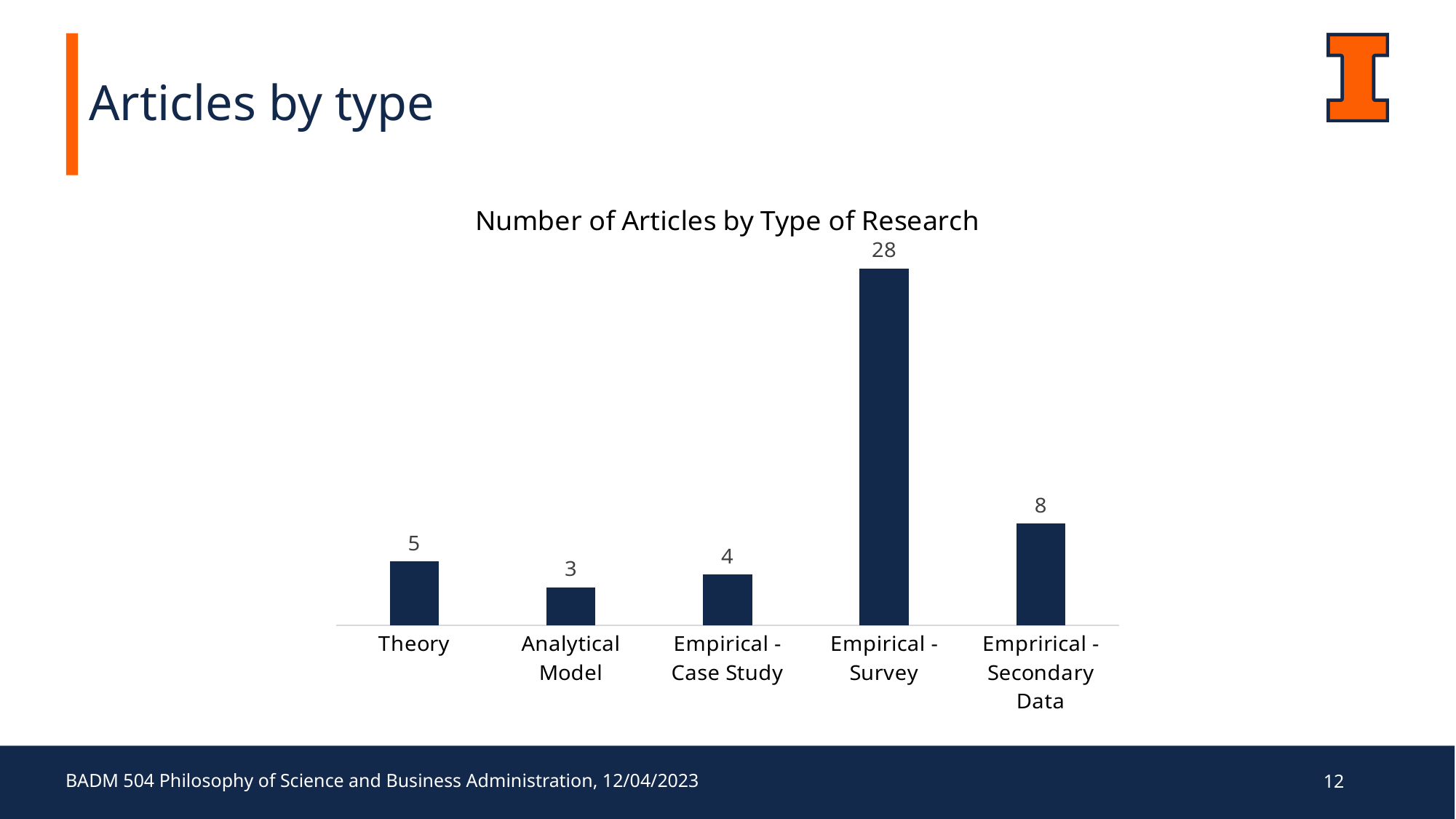
What is the number of articles for Emprirical - Secondary Data? 8 What is the number of articles for Empirical - Case Study? 4 Which has more articles, Theory or Empirical - Case Study? Theory What is the number of articles for Analytical Model? 3 What is the number of articles for Theory? 5 What is the title of the chart? Number of Articles by Type of Research Which type of research has the highest number of articles? Empirical - Survey What is the number of articles for Empirical - Survey? 28 How many types of research are shown on the chart? 5 What kind of chart is shown on the slide? Bar chart Which type of research has the lowest number of articles? Analytical Model What is the difference between the number of articles for Empirical - Survey and Emprirical - Secondary Data? 20